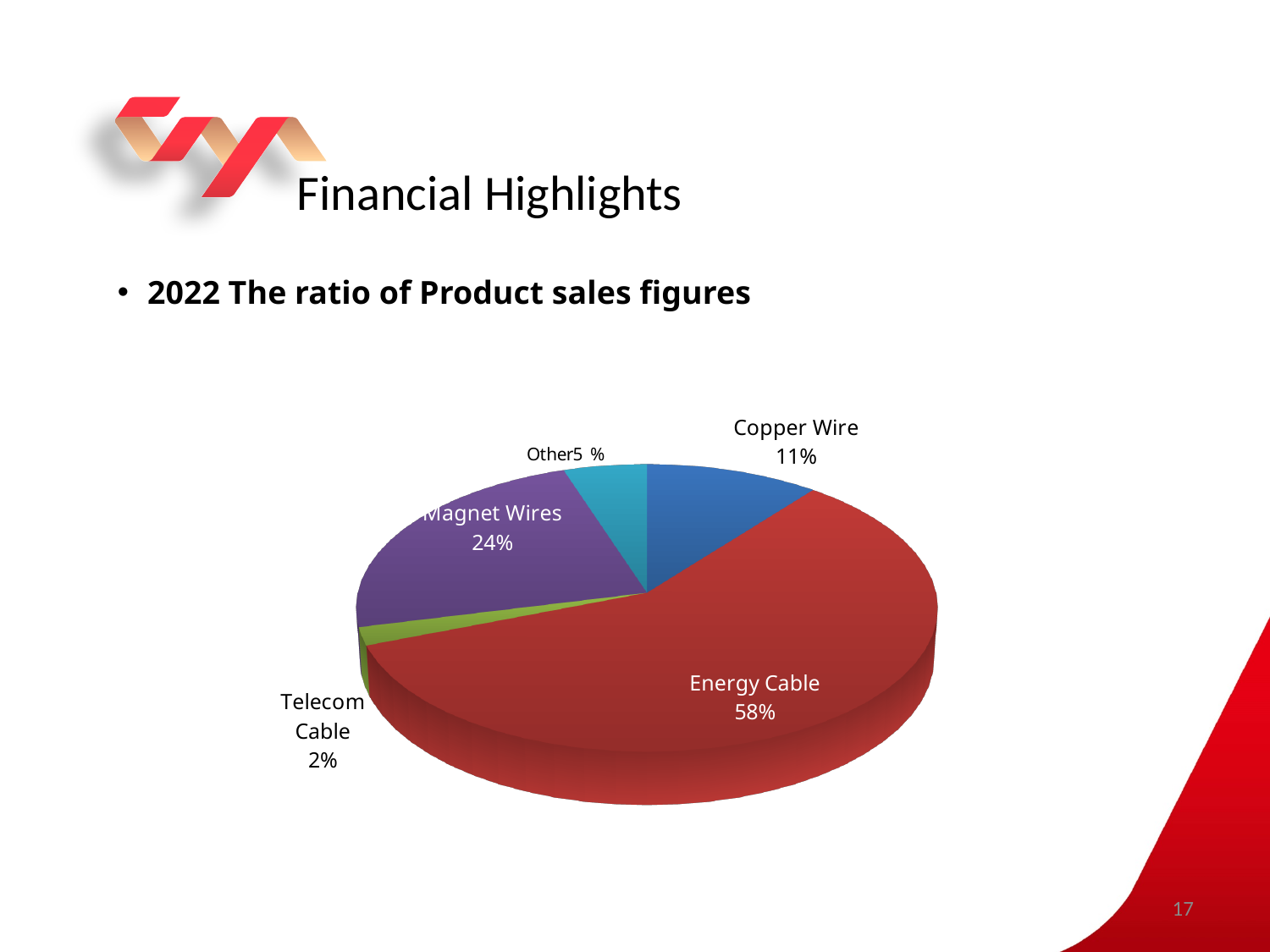
What share of product sales does Energy Cable account for? 58% Which year does the product sales ratio chart refer to? 2022 What share of product sales does Telecom Cable account for? 2% What is the difference in percentage points between the Energy Cable share and the Magnet Wires share? 34 Which product category has the largest share of sales? Energy Cable What share of product sales does Magnet Wires account for? 24% Which has a larger share of sales, Copper Wire or Other? Copper Wire What kind of chart is shown on the slide? Pie chart What share of product sales does Copper Wire account for? 11% What share of product sales does Other account for? 5% How many product categories are shown in the pie chart? 5 Which product category has the smallest share of sales? Telecom Cable